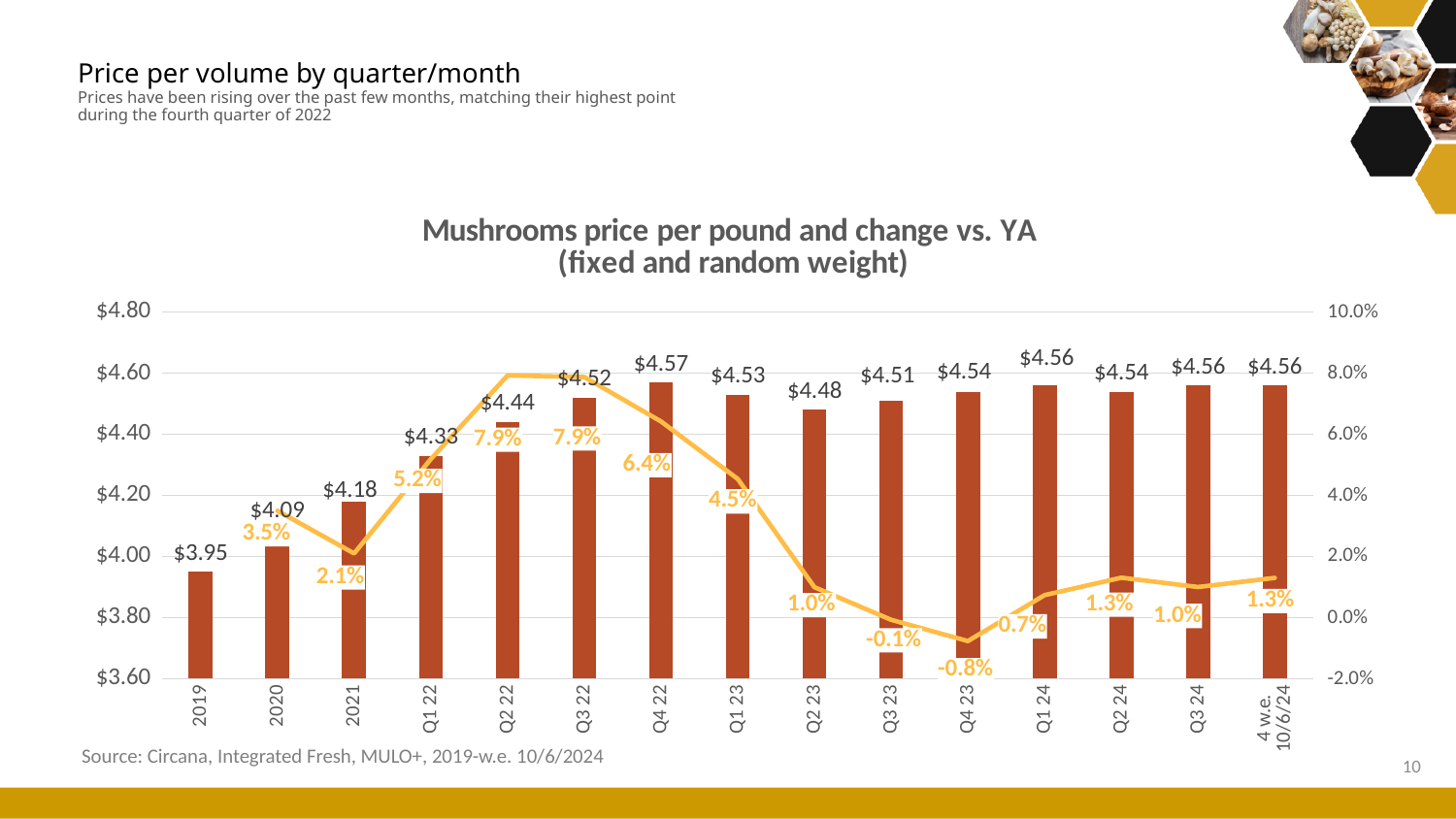
What is the price per pound for 2019? $3.95 What is the mushroom price per pound for Q4 22? $4.57 Which period has the highest price per pound? Q4 22 What kind of chart is this? Combined bar and line chart Which period has the lowest change vs. YA? Q4 23 What is the title of the chart? Mushrooms price per pound and change vs. YA (fixed and random weight) What is the difference in price per pound between Q4 22 and 2019? $0.62 What is the change vs. YA for Q1 22? 5.2% What is the change vs. YA shown for Q4 23? -0.8% Did the price per pound rise or fall from 2019 to Q4 22? Rise Which is higher, the price per pound in Q2 23 or in Q3 23? Q3 23 How many periods are shown on the x axis? 15